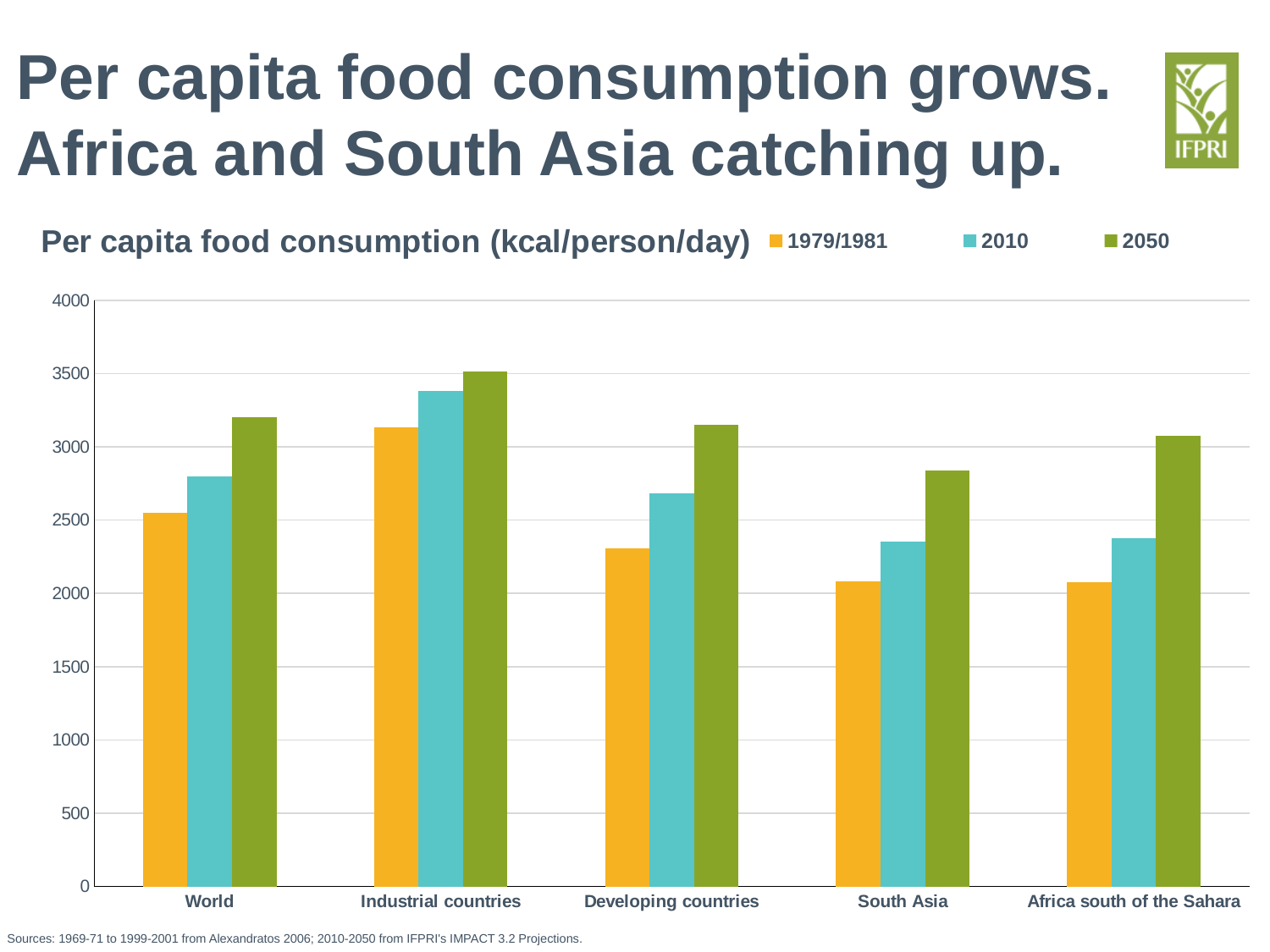
How many series does the legend list? 3 Which region has the highest value for 2050? Industrial countries Is the value for South Asia in 2050 greater or less than 3000? less What kind of chart is shown on the slide? Bar chart Which region has the highest value for 1979/1981? Industrial countries Is the value for Developing countries in 1979/1981 greater or less than 2500? less What is the title of the chart? Per capita food consumption (kcal/person/day) For each region, do the values rise or fall from 1979/1981 to 2050? rise Which region has the lowest value for 2050? South Asia How many regions (categories) are shown on the x axis? 5 Is the value for Industrial countries in 2010 greater or less than 3000? greater Which is larger: the 2050 value for Africa south of the Sahara or the 2050 value for South Asia? Africa south of the Sahara